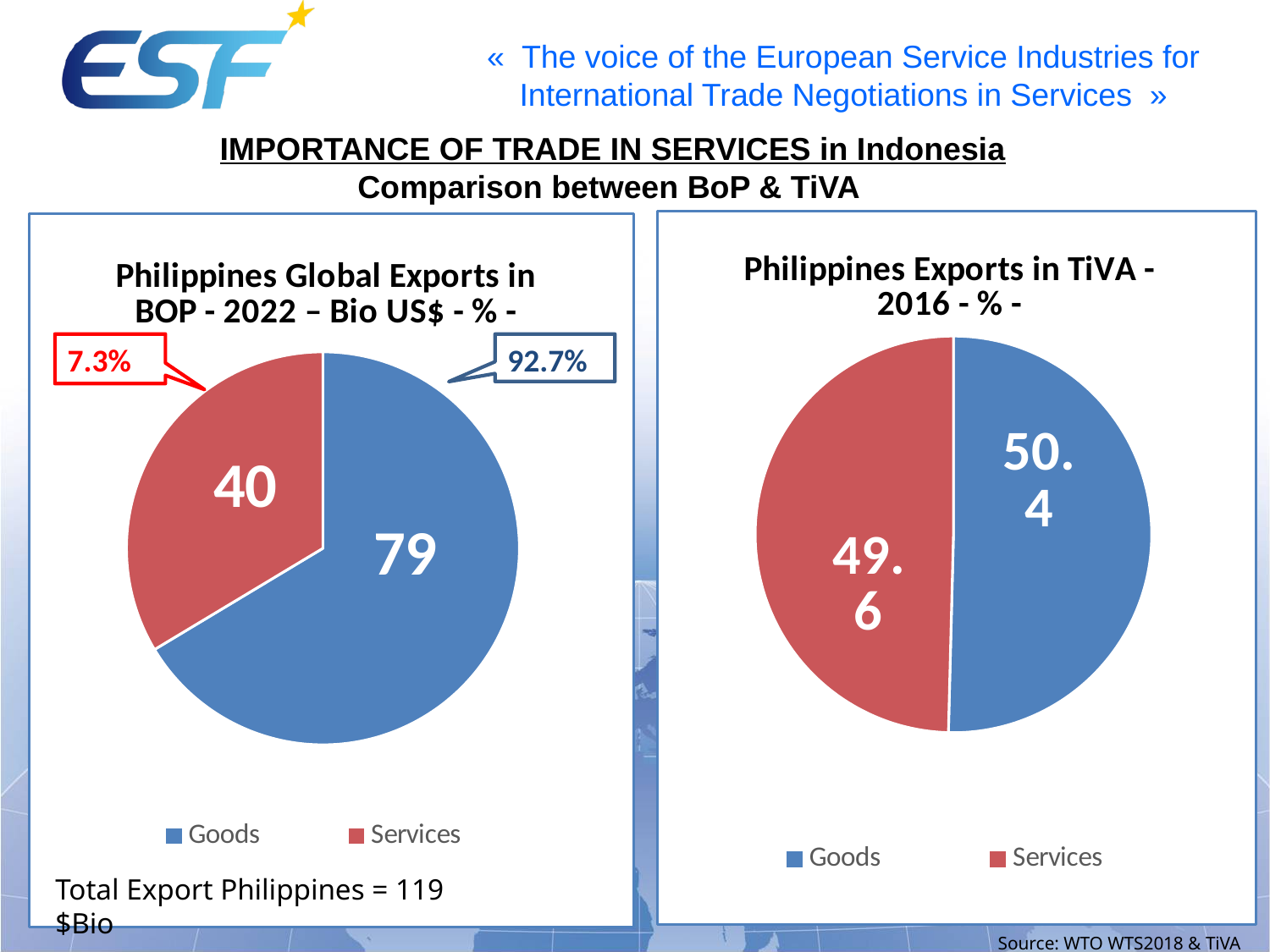
In the 'Philippines Exports in TiVA - 2016' chart, what is the value for Goods? 50.4 In the 'Philippines Global Exports in BOP - 2022' chart, what is the value for Goods? 79 In the 'Philippines Global Exports in BOP - 2022' chart, which category has the largest slice? Goods In the 'Philippines Exports in TiVA - 2016' chart, how many slices does the pie have? 2 According to the text below the left chart, what is the total export of the Philippines? 119 $Bio In the 'Philippines Exports in TiVA - 2016' chart, what is the value for Services? 49.6 In the 'Philippines Global Exports in BOP - 2022' chart, how many categories does the legend list? 2 In the 'Philippines Exports in TiVA - 2016' chart, what colour represents Services? Red In the 'Philippines Global Exports in BOP - 2022' chart, what is the value for Services? 40 What type of chart is the 'Philippines Global Exports in BOP - 2022' chart? Pie chart In the 'Philippines Global Exports in BOP - 2022' chart, what is the difference between the Goods and Services values? 39 In the 'Philippines Exports in TiVA - 2016' chart, which is larger, Goods or Services? Goods